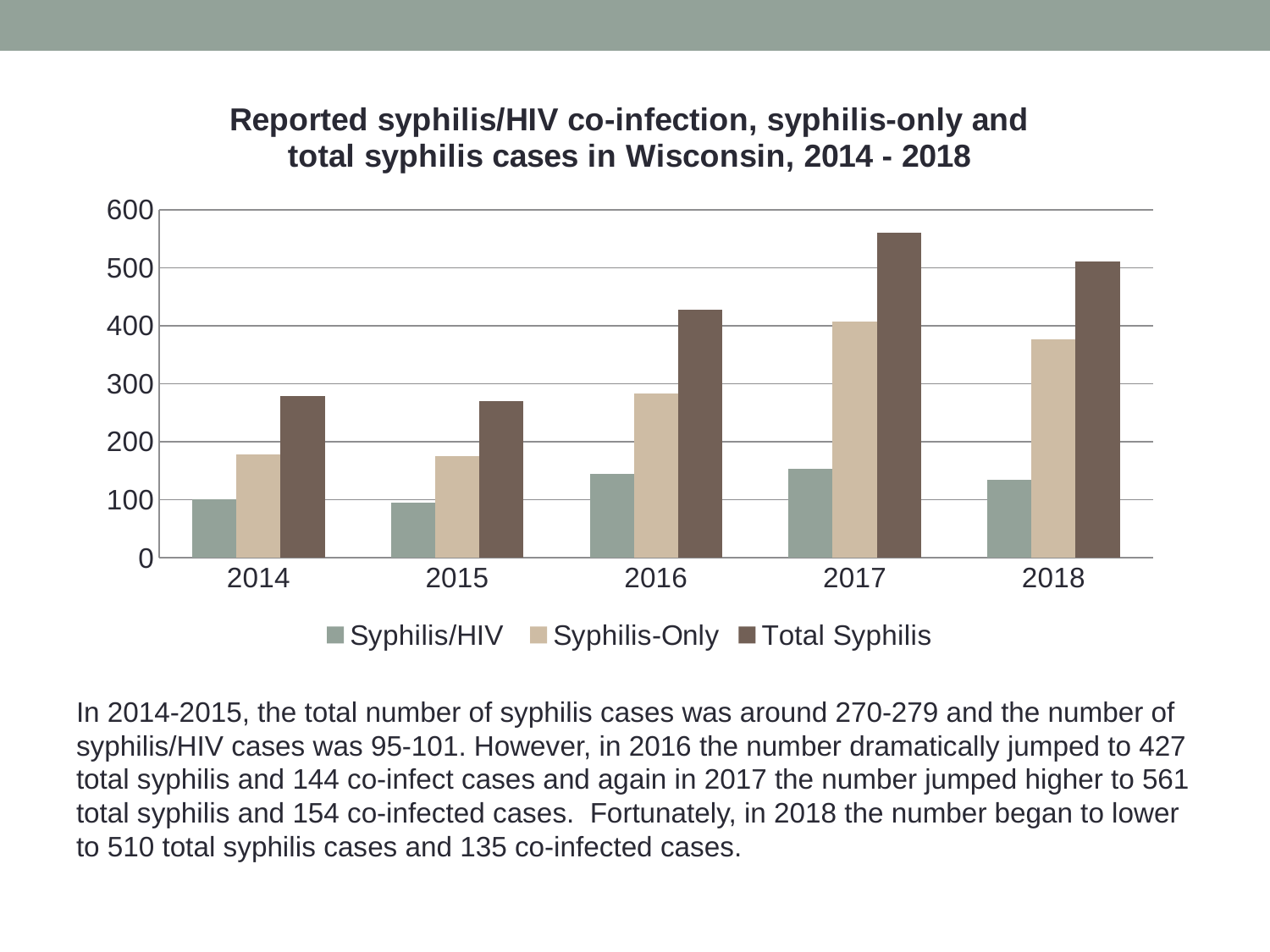
Is the Syphilis-Only value for 2016 greater or less than 300? less Is the Syphilis-Only value for 2014 greater or less than 200? less By how much did total syphilis cases fall from 2017 (561) to 2018 (510)? 51 According to the slide, what was the number of total syphilis cases in 2017? 561 How many years are shown on the x axis? 5 Is the Total Syphilis value for 2014 greater or less than 300? less In which year is the Total Syphilis bar highest? 2017 In which year is the Syphilis/HIV bar lowest? 2015 What kind of chart is shown on the slide? bar chart Which is larger, the Total Syphilis value for 2016 or for 2018? 2018 How many series does the legend list? 3 According to the slide, what was the number of co-infected (Syphilis/HIV) cases in 2018? 135